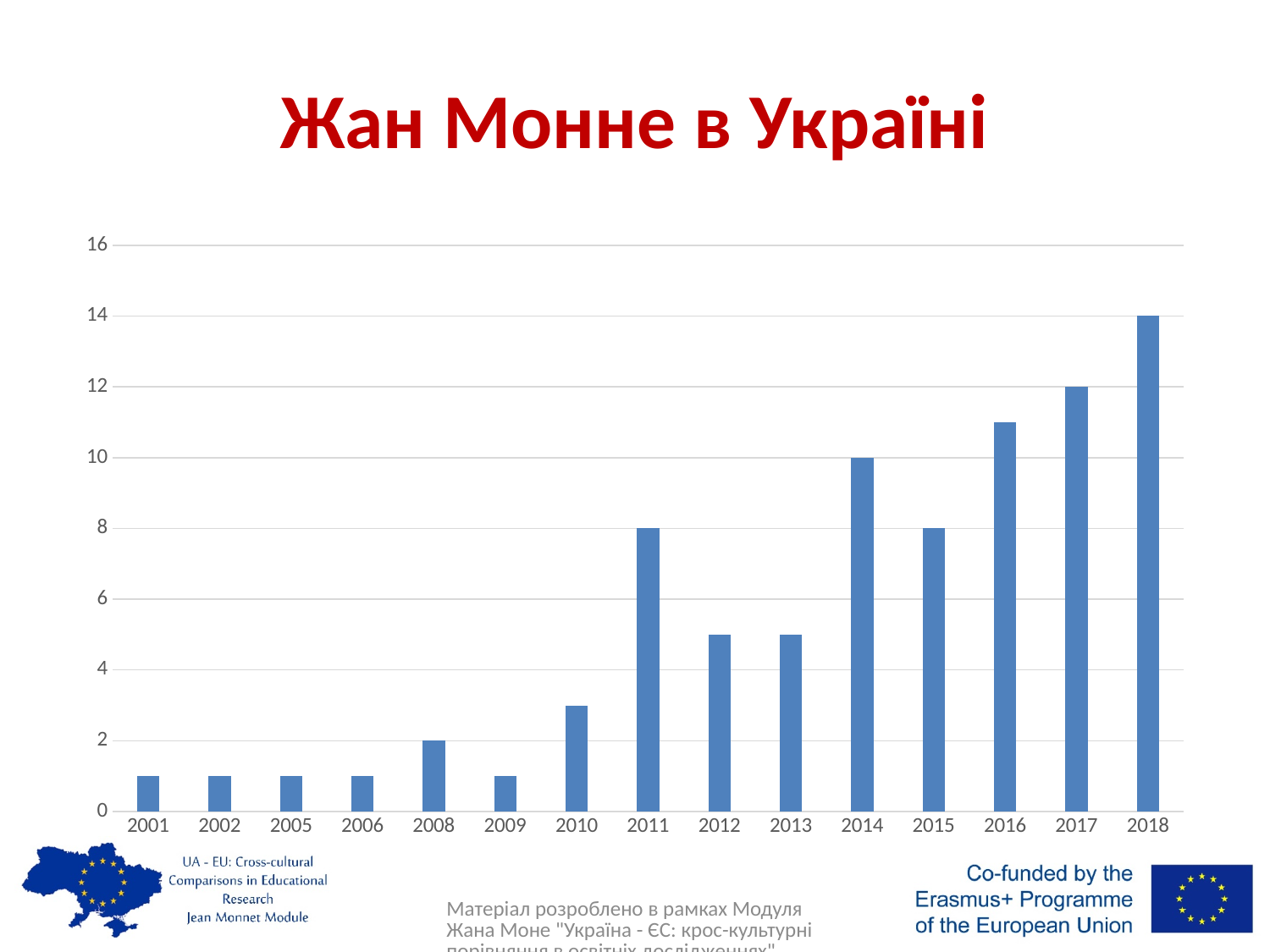
What type of chart is shown on the slide? bar chart Which year has the highest bar in the chart? 2018 How many years are shown on the x axis of the chart? 15 What is the value for 2018? 14 Do the values generally rise or fall from 2001 to 2018? rise What is the value for 2011? 8 What is the value for 2017? 12 What is the value for 2014? 10 What is the value for 2008? 2 Which is larger, the value for 2016 or the value for 2015? 2016 Is the value for 2012 greater or less than 4? greater What is the difference between the values for 2018 and 2017? 2